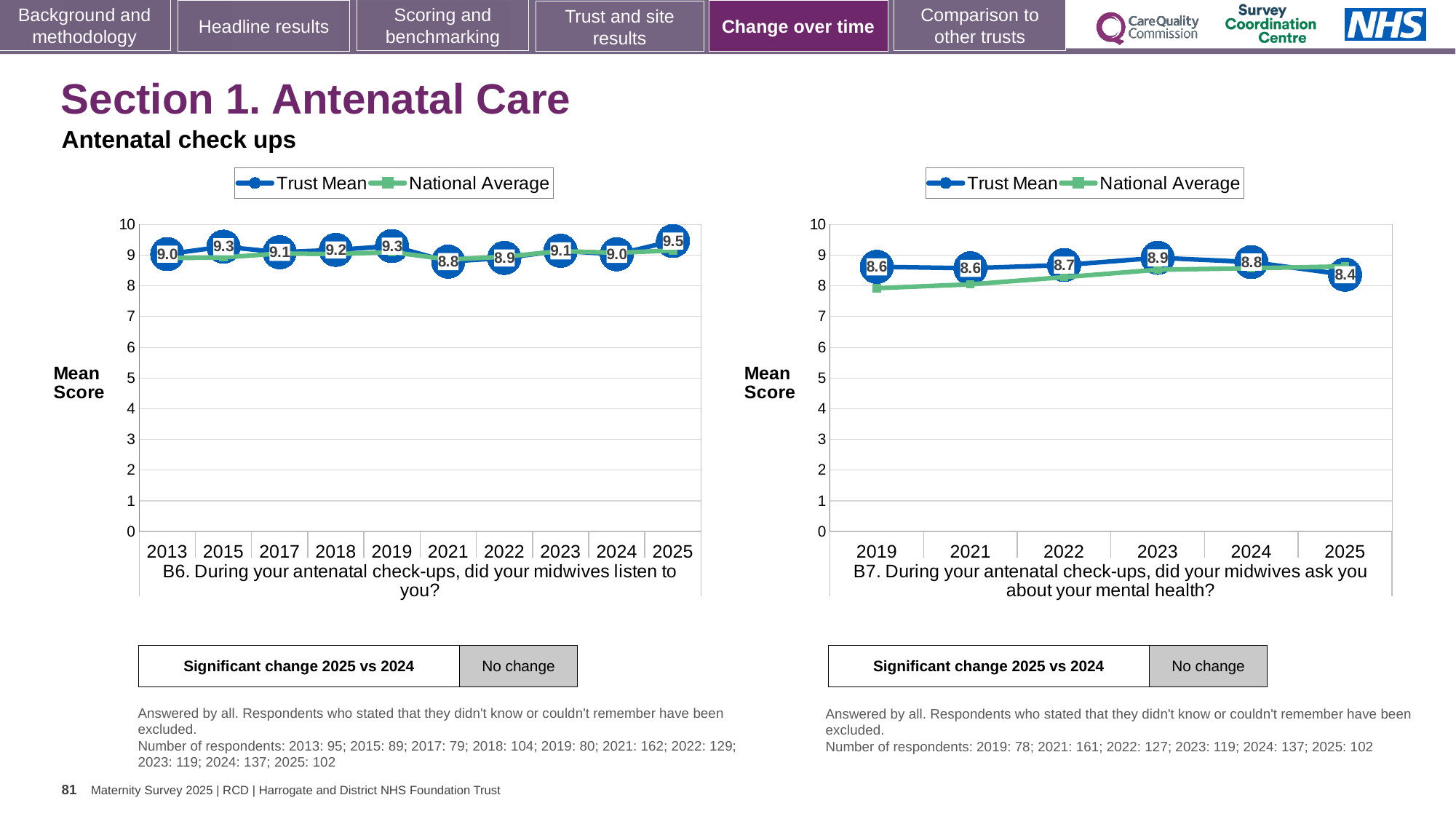
In the left chart (B6), what is the Trust Mean score for 2025? 9.5 In the right chart (B7), which year has the lowest Trust Mean score? 2025 In the left chart (B6), which year has the lowest Trust Mean score? 2021 What type of chart is the left chart (B6)? Line chart In the left chart (B6), is the Trust Mean score higher in 2015 or in 2024? 2015 How many years are plotted on the x axis of the right chart (B7)? 6 In the left chart (B6), which year has the highest Trust Mean score? 2025 In the left chart (B6), what is the Trust Mean score for 2021? 8.8 How many series does the legend of the left chart (B6) list? 2 In the right chart (B7), what is the Trust Mean score for 2023? 8.9 In the right chart (B7), what is the Trust Mean score for 2025? 8.4 In the right chart (B7), what is the difference between the Trust Mean scores for 2023 and 2025? 0.5